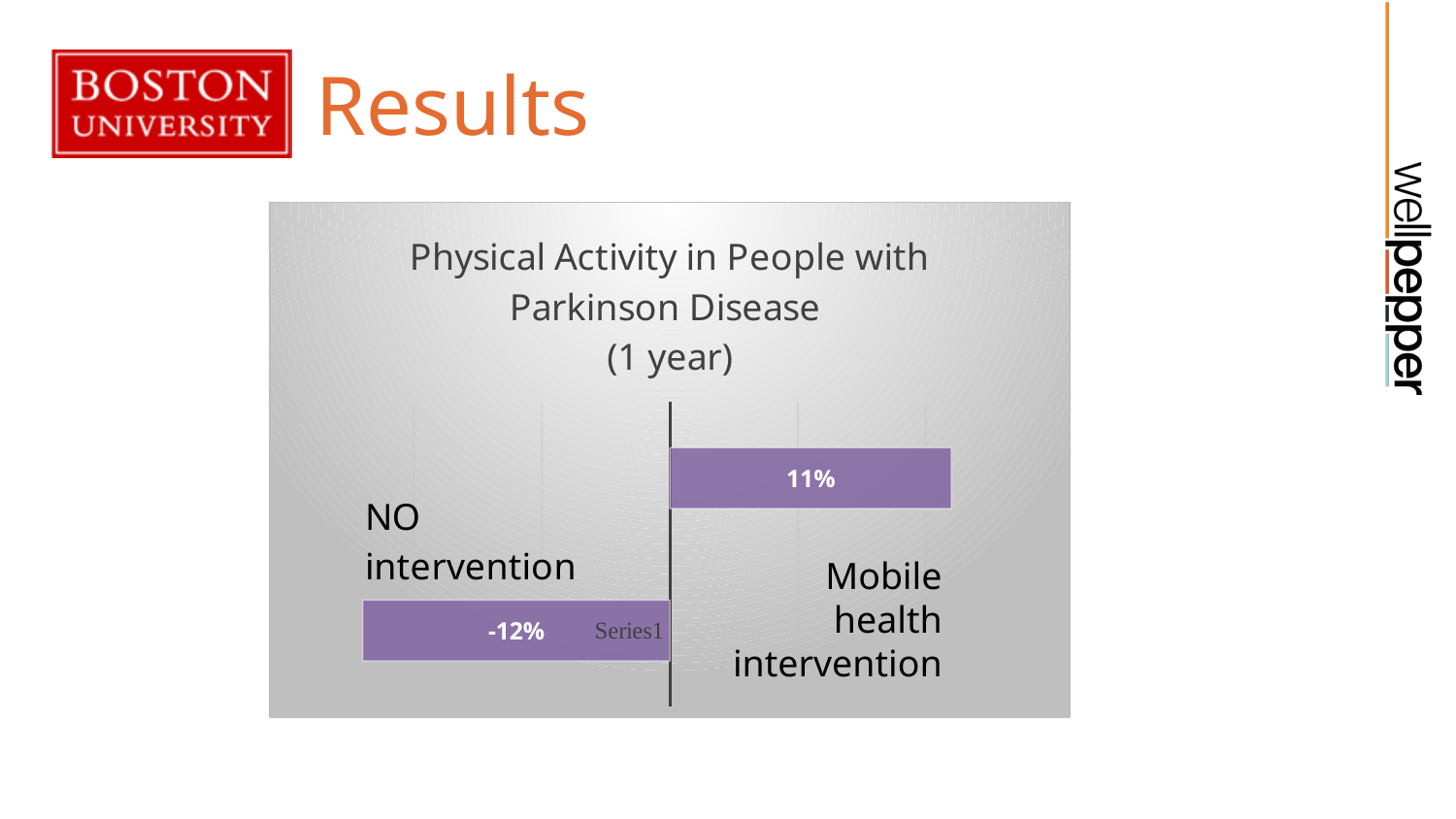
What is the difference between the Mobile health intervention value and the NO intervention value? 23 percentage points What is the title of the chart? Physical Activity in People with Parkinson Disease (1 year) What series name is printed next to the NO intervention bar? Series1 What is the value for the Mobile health intervention bar? 11% What is the value for the NO intervention bar? -12% Which category has the higher value, NO intervention or Mobile health intervention? Mobile health intervention Which category has the highest value? Mobile health intervention How many bars are plotted in the chart? 2 Which category has the lowest value? NO intervention Is the value for NO intervention positive or negative? Negative What kind of chart is shown on the slide? Bar chart